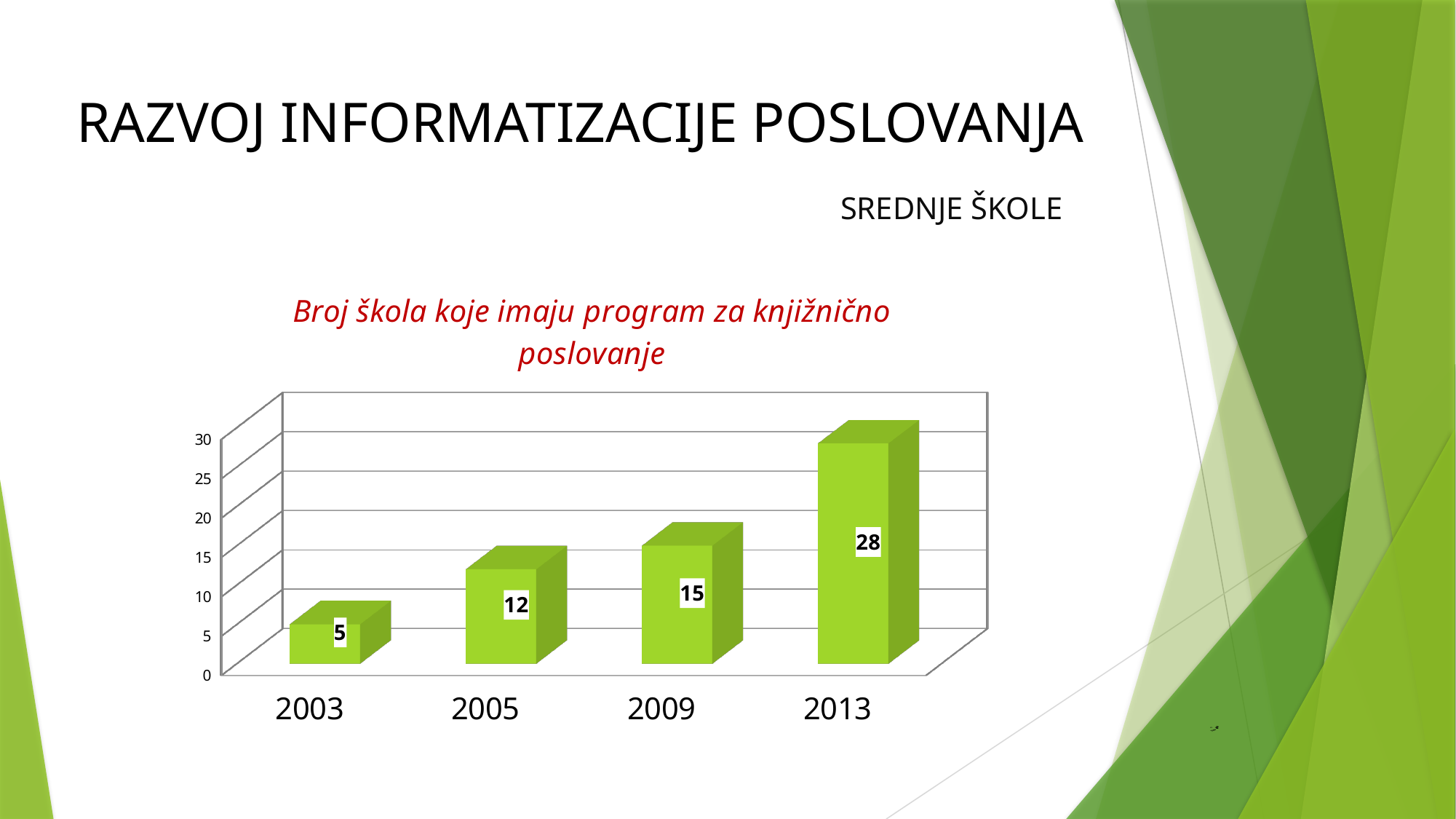
Which year has the lowest value? 2003 What is the value for 2013? 28 What kind of chart is shown on the slide? bar chart What is the difference between the values for 2005 and 2003? 7 Which is larger, the value for 2005 or the value for 2009? 2009 What is the value for 2005? 12 Do the values rise or fall from 2003 to 2013? rise What is the value for 2009? 15 What is the value for 2003? 5 What is the difference between the values for 2013 and 2009? 13 How many years are shown on the x axis? 4 Which year has the highest value? 2013